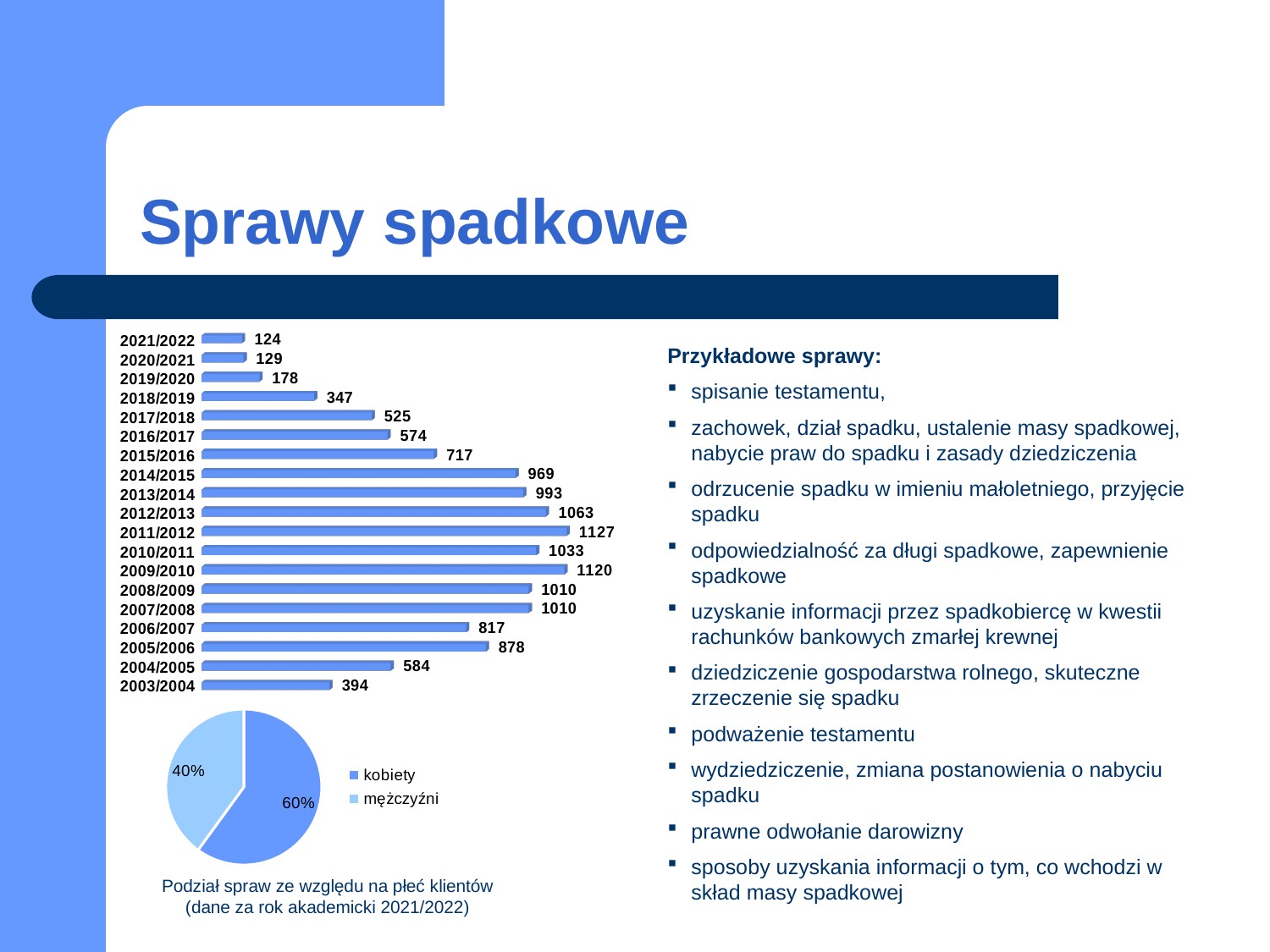
How many academic years are shown in the bar chart? 19 In the bar chart, which academic year has the lowest value? 2021/2022 In the bar chart, what is the difference between the values for 2009/2010 and 2019/2020? 942 In the bar chart, which academic year has the highest value? 2011/2012 In the bar chart, which is larger: the value for 2005/2006 or the value for 2006/2007? 2005/2006 In the bar chart, what is the value for 2015/2016? 717 In the bar chart, what is the value for 2003/2004? 394 In the pie chart, what share is labelled for mężczyźni? 40% How many entries does the legend of the pie chart list? 2 In the bar chart, what is the value for 2011/2012? 1127 What type of chart is the upper chart on the slide? bar chart In the pie chart, what share is labelled for kobiety? 60%